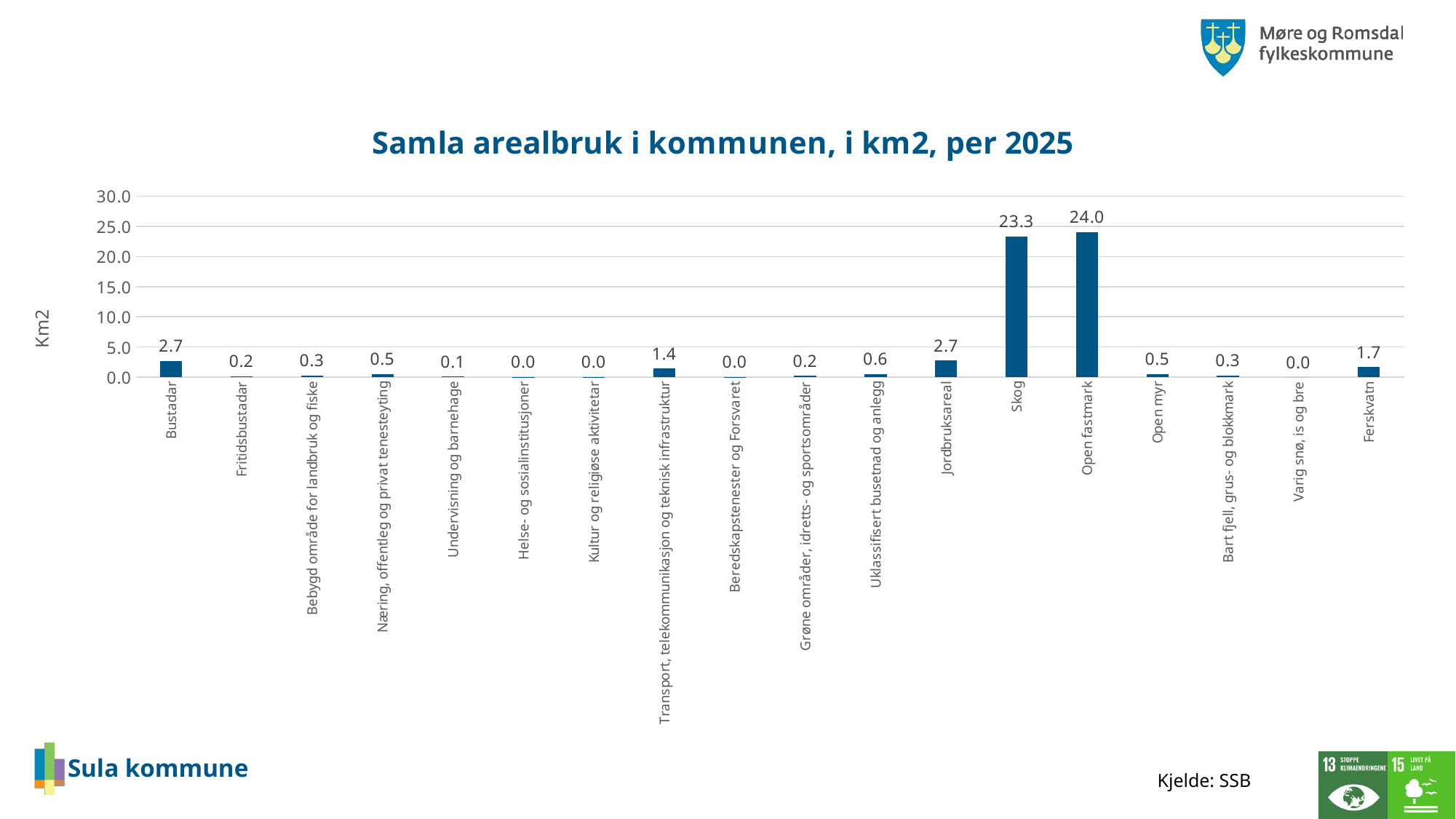
What is the label on the y axis? Km2 What is the value for Ferskvatn? 1.7 How many categories are shown on the x axis? 18 What kind of chart is shown on the slide? bar chart Which category has the highest value? Open fastmark What is the value for Skog? 23.3 What is the title of the chart? Samla arealbruk i kommunen, i km2, per 2025 What is the value for Transport, telekommunikasjon og teknisk infrastruktur? 1.4 Which is larger, the value for Bustadar or the value for Ferskvatn? Bustadar What is the difference between the values for Open fastmark and Skog? 0.7 What is the value for Uklassifisert busetnad og anlegg? 0.6 How many categories have a value of 0.0? 4